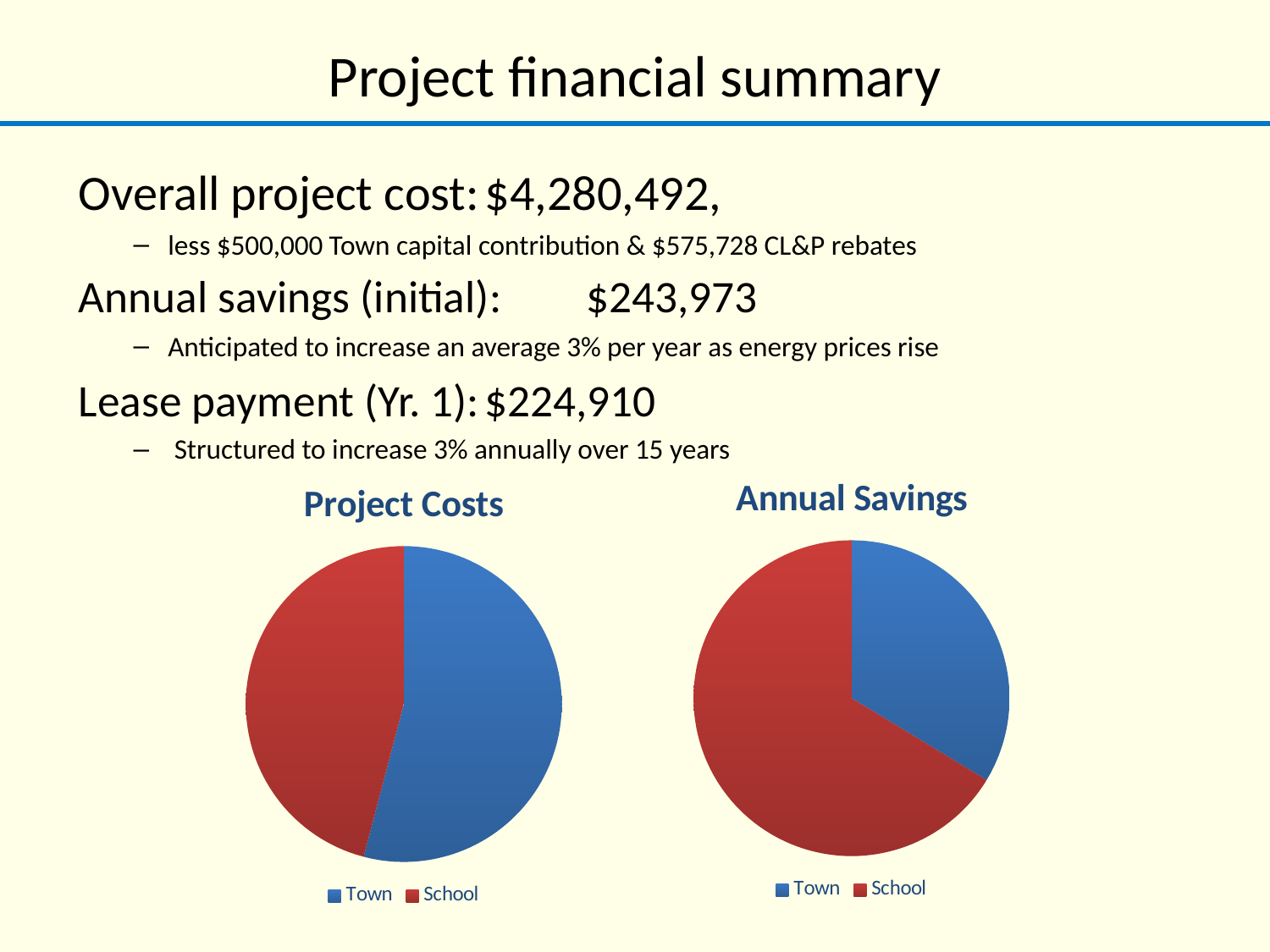
In the Annual Savings chart, which category has the smallest share? Town How many slices does the Annual Savings pie chart have? 2 In the Project Costs chart, what colour is the School slice? red In the Annual Savings chart, which slice is larger, Town or School? School In the Annual Savings chart, which category has the largest share? School What kind of chart is the Project Costs chart? pie chart What are the legend entries of the Annual Savings chart? Town, School How many charts are shown on the slide? 2 How many slices does the Project Costs pie chart have? 2 How many entries does the legend of the Project Costs chart list? 2 What kind of chart is the Annual Savings chart? pie chart